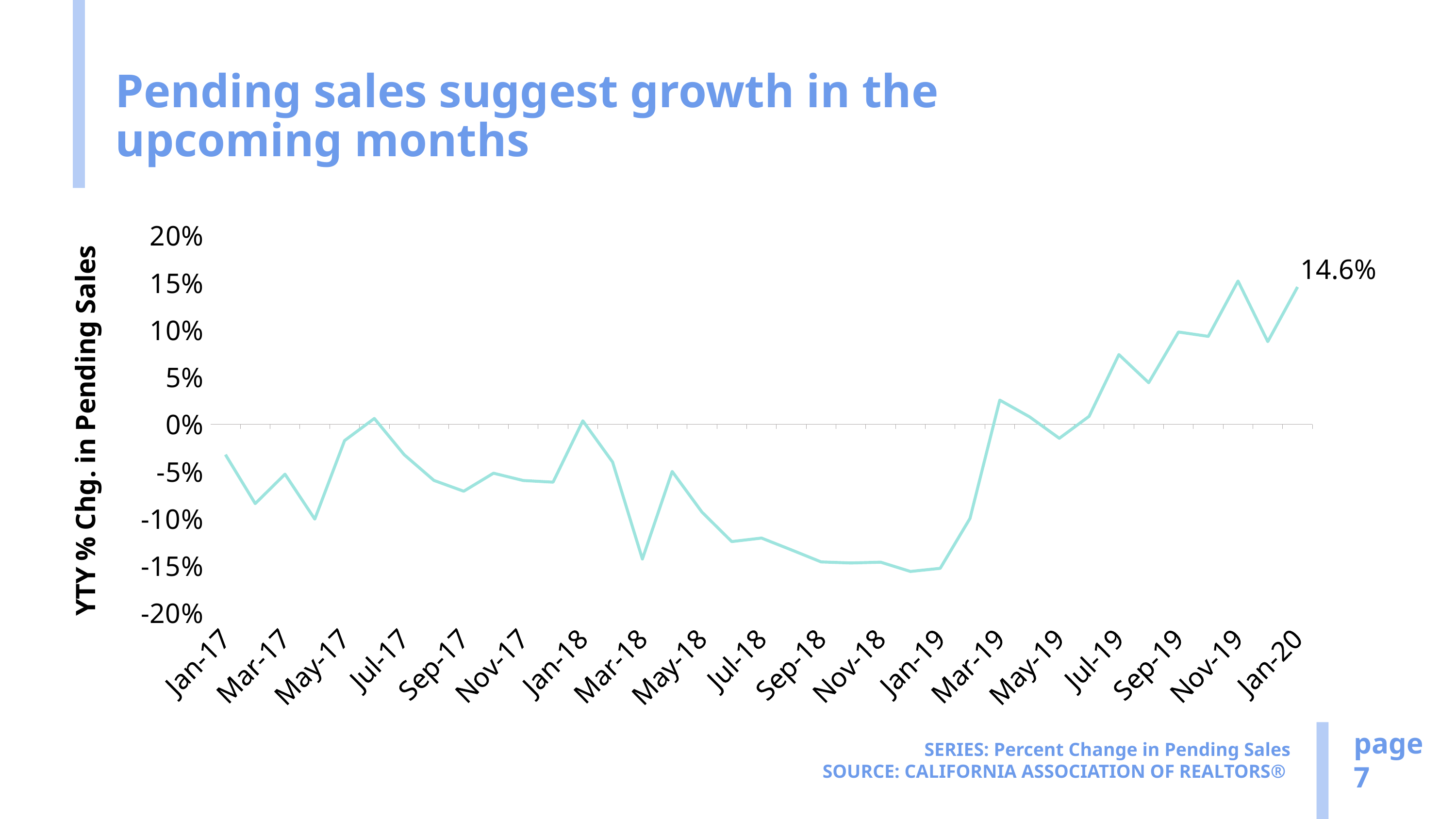
Is the value for Mar-18 greater or less than -10%? less Which is larger, the value for Mar-18 or the value for Mar-19? Mar-19 What kind of chart is shown on the slide? line chart How many month labels are shown on the x axis? 19 Is the value for Nov-19 greater or less than 10%? greater Is the value for Jan-17 greater or less than 0%? less Do the values rise or fall between Jan-19 and Jul-19? rise Do the values rise or fall between Jan-18 and Mar-18? fall What is the value for Jan-20 on the chart? 14.6% What is the title of the y axis? YTY % Chg. in Pending Sales Which is larger, the value for Jan-17 or the value for Jan-20? Jan-20